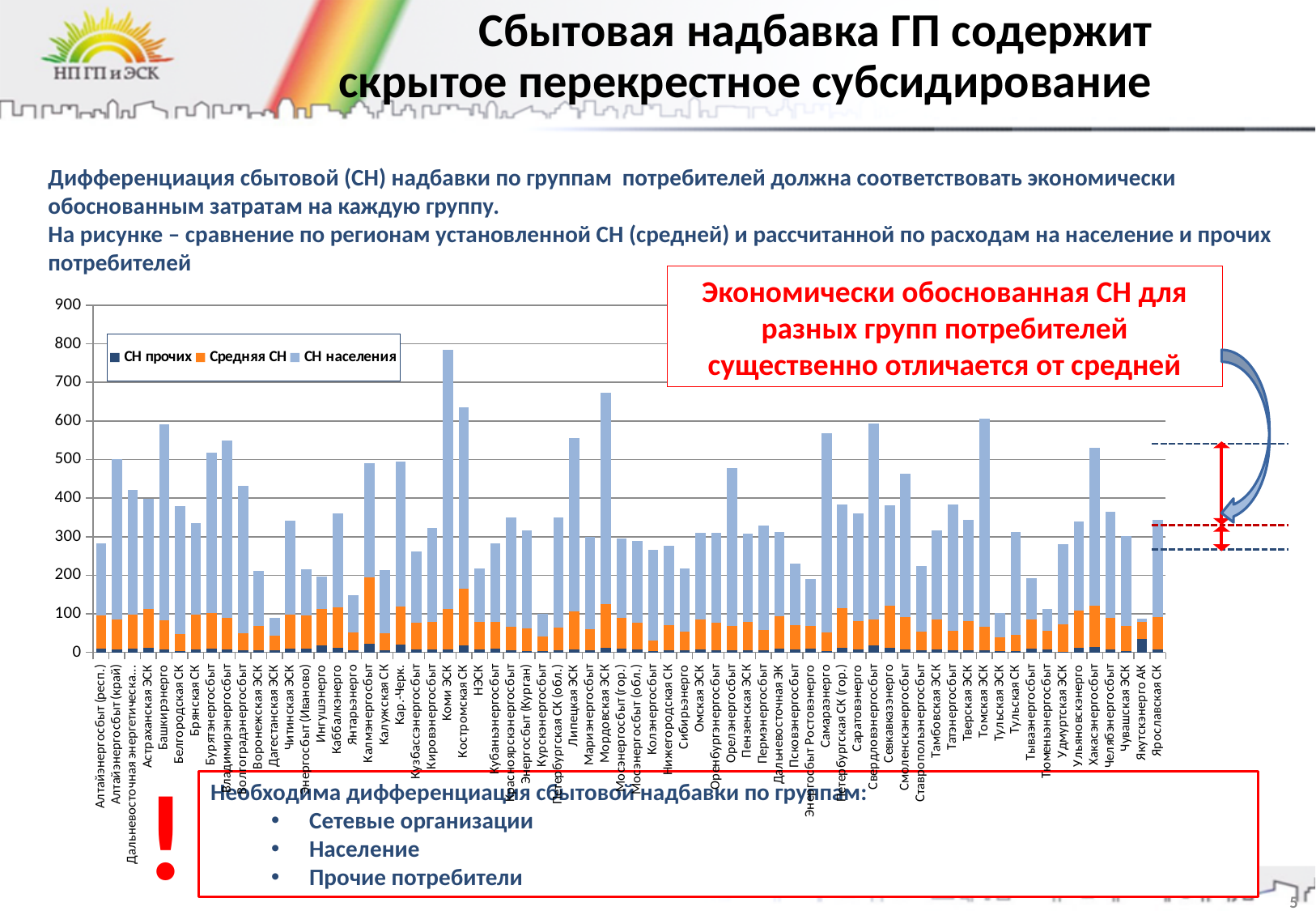
Which region has the tallest bar in the chart? Коми ЭСК Is the total bar for Мордовская ЭСК greater or less than 600? greater Which bar is taller, Башкирэнерго or Брянская СК? Башкирэнерго Which colour represents the series 'Средняя СН' in the chart? Orange What kind of chart is shown on the slide? Stacked bar chart Is the total bar for Коми ЭСК greater or less than 700? greater Is the total bar for Липецкая ЭСК greater or less than 500? greater Which series are listed in the chart legend? СН прочих, Средняя СН, СН населения How many series does the chart legend list? 3 Which bar is taller, Коми ЭСК or Мордовская ЭСК? Коми ЭСК